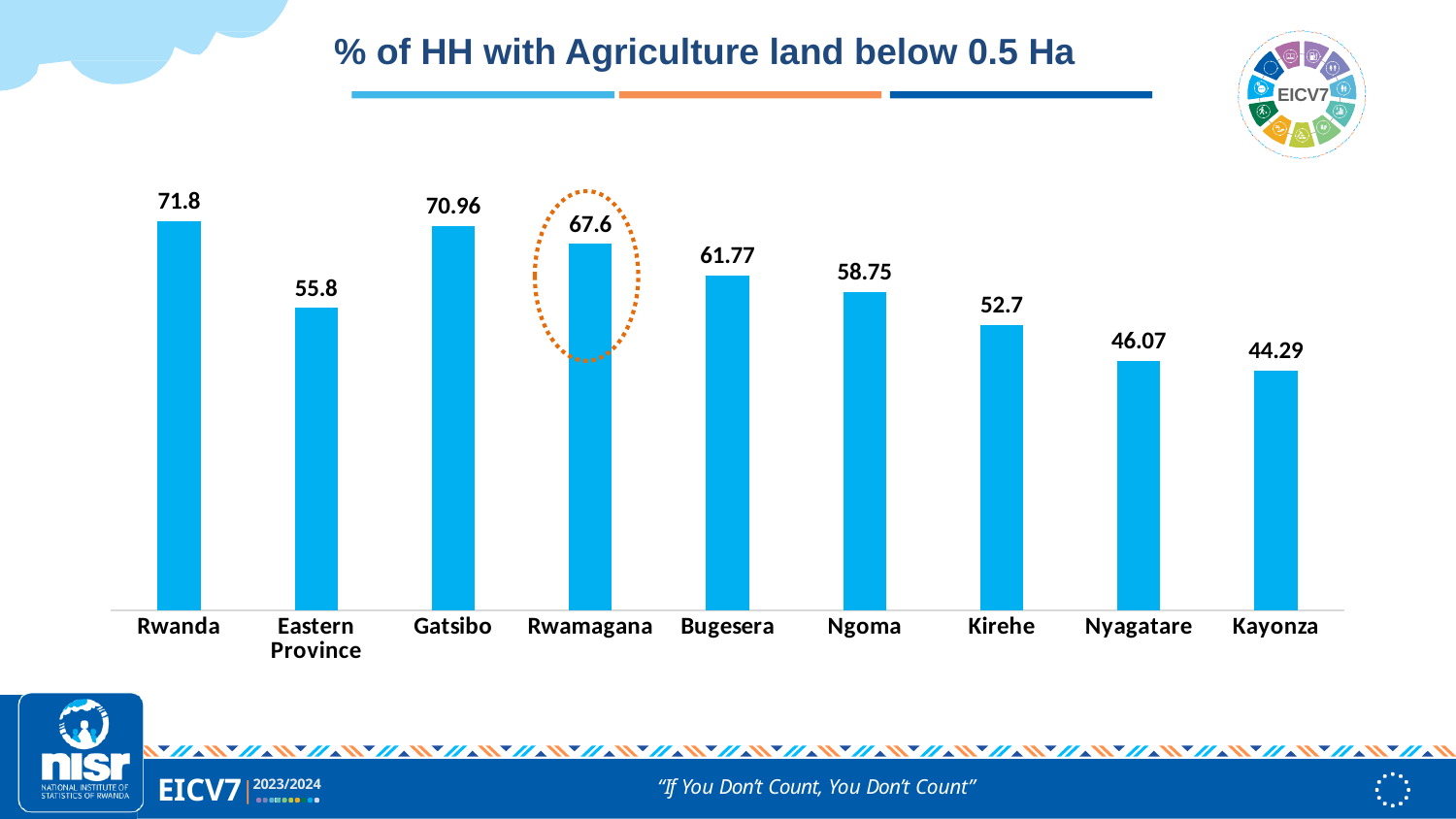
What kind of chart is shown on the slide? Bar chart What is the difference between the values for Rwanda and Eastern Province? 16 What is the value for Rwamagana? 67.6 What is the title of the chart? % of HH with Agriculture land below 0.5 Ha Which category has the highest value? Rwanda Which is larger, the value for Kirehe or the value for Nyagatare? Kirehe What is the value for Gatsibo? 70.96 What is the value for Eastern Province? 55.8 What is the difference between the values for Bugesera and Ngoma? 3.02 How many categories are shown on the x axis? 9 What is the value for Kayonza? 44.29 Which category has the lowest value? Kayonza